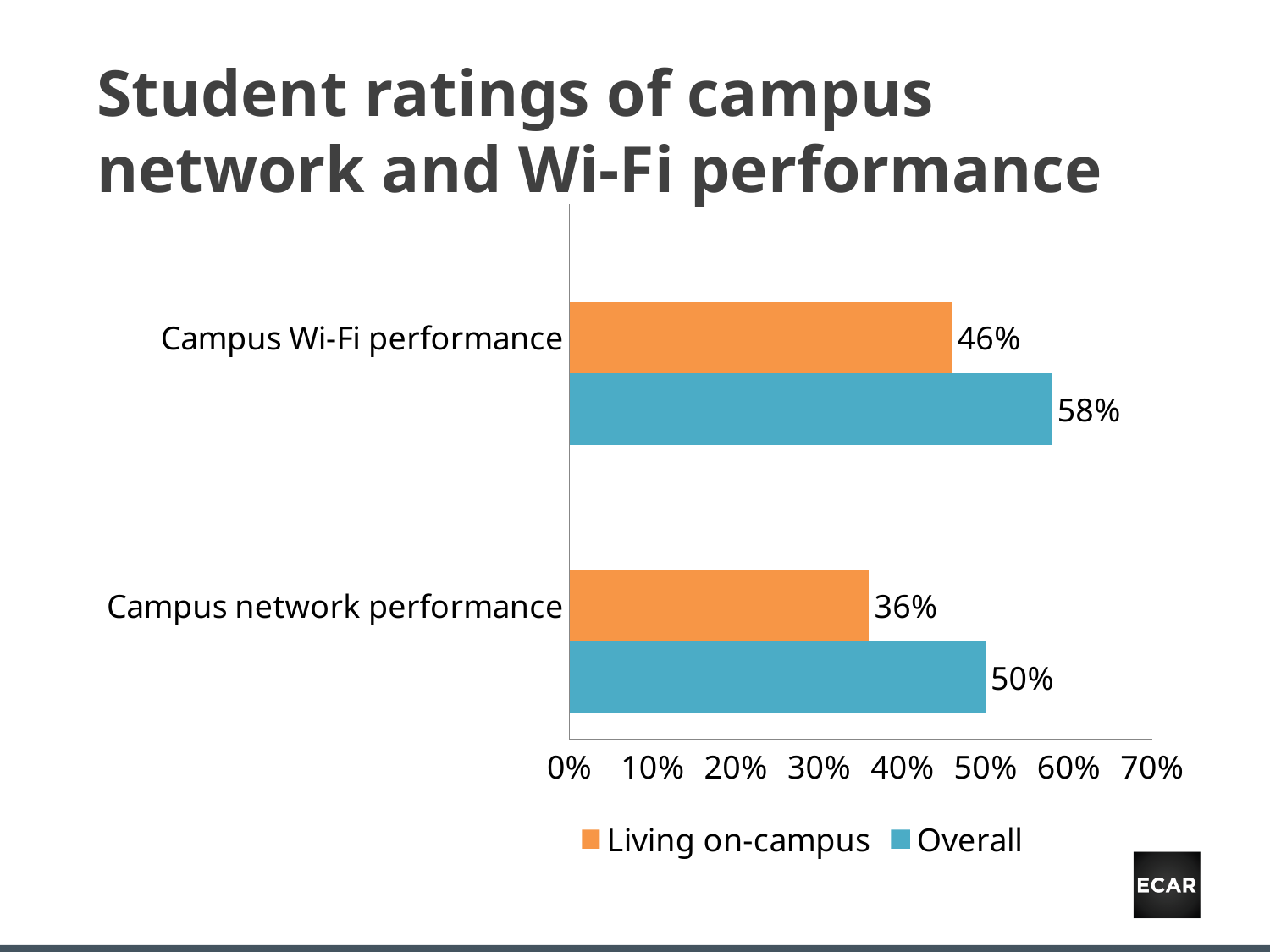
Which category has the lowest Living on-campus value? Campus network performance For Campus network performance, which is larger: the Living on-campus value or the Overall value? Overall How many categories are shown on the chart? 2 What is the Overall value for Campus network performance? 50% What is the difference between the Overall and Living on-campus values for Campus Wi-Fi performance? 12% Which category has the highest Overall value? Campus Wi-Fi performance What is the Living on-campus value for Campus Wi-Fi performance? 46% What is the difference between the Overall and Living on-campus values for Campus network performance? 14% What kind of chart is shown on the slide? Bar chart What is the Overall value for Campus Wi-Fi performance? 58% What is the Living on-campus value for Campus network performance? 36% How many series does the legend list? 2